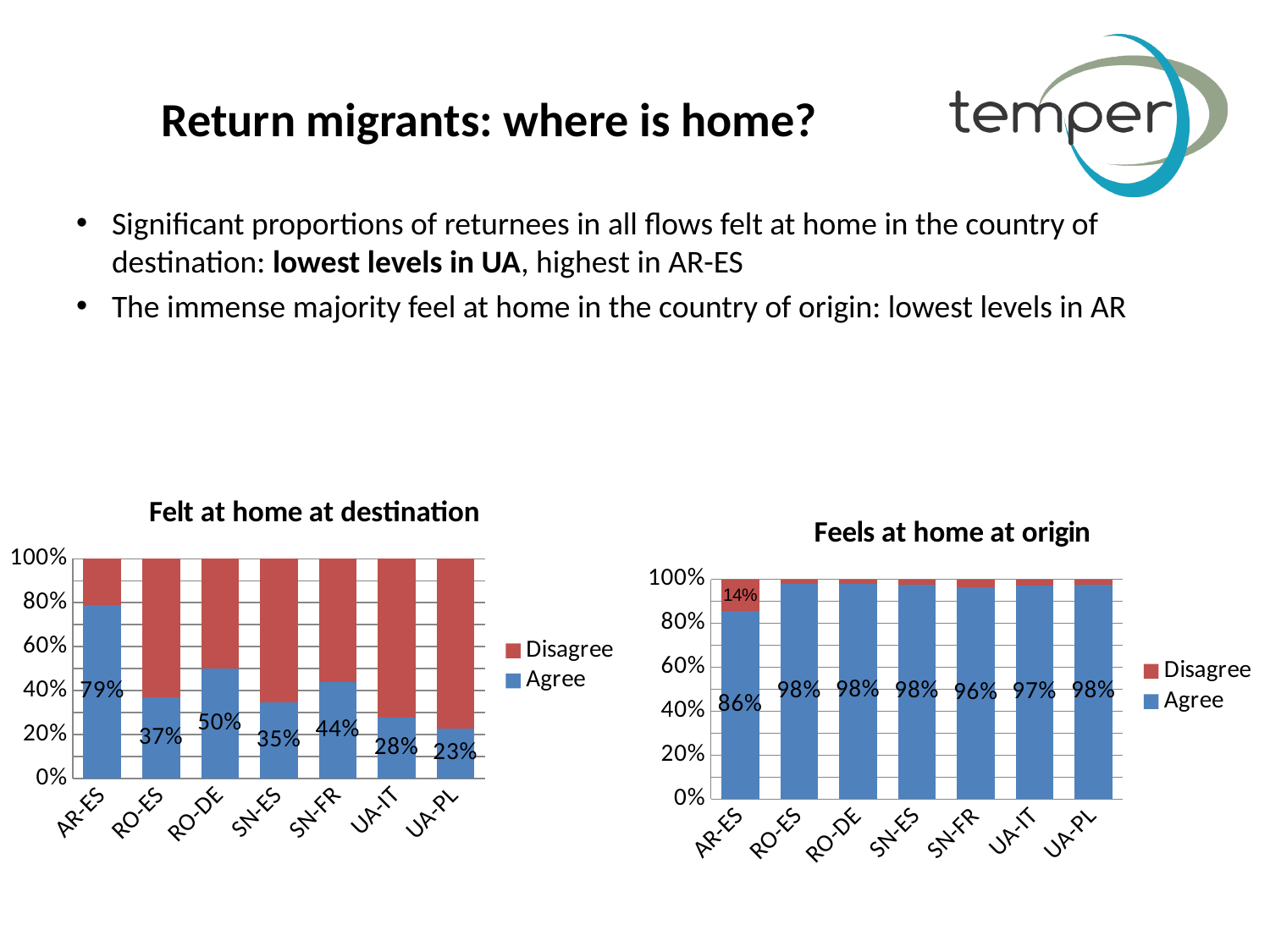
How many categories are shown on the x axis of the 'Felt at home at destination' chart? 7 What kind of chart is the 'Felt at home at destination' chart? Stacked bar chart In the 'Felt at home at destination' chart, is the Agree value larger for RO-DE or SN-ES? RO-DE In the 'Feels at home at origin' chart, which category has the lowest Agree value? AR-ES In the 'Feels at home at origin' chart, what is the Disagree value for AR-ES? 14% In the 'Felt at home at destination' chart, what is the Agree value for AR-ES? 79% In the 'Felt at home at destination' chart, which category has the highest Agree value? AR-ES How many series does the legend of the 'Feels at home at origin' chart list? 2 In the 'Feels at home at origin' chart, what is the Agree value for SN-FR? 96% In the 'Felt at home at destination' chart, what is the Agree value for SN-FR? 44% In the 'Felt at home at destination' chart, what is the difference between the Agree values for AR-ES and UA-PL? 56% In the 'Felt at home at destination' chart, which category has the lowest Agree value? UA-PL